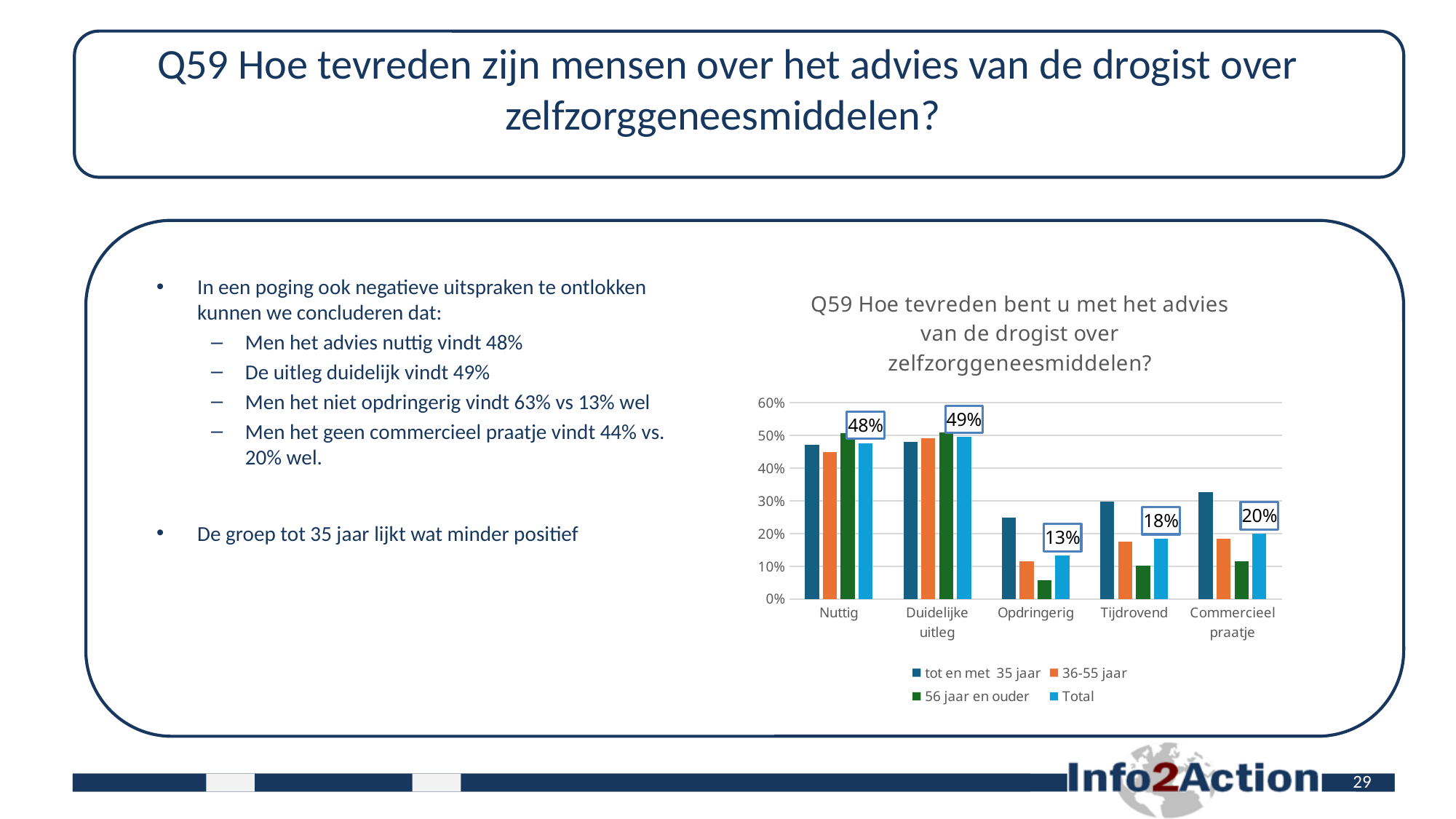
Is the value for '56 jaar en ouder' in Opdringerig greater or less than 10%? less How many categories are shown on the x axis? 5 Is the value for 'tot en met 35 jaar' in Commercieel praatje greater or less than 30%? greater What is the Total value for Opdringerig? 13% How many series does the legend list? 4 What is the difference between the Total values for Commercieel praatje and Opdringerig? 7 percentage points Which category has the highest labelled Total value? Duidelijke uitleg What is the Total value for Commercieel praatje? 20% What kind of chart is shown on the slide? Bar chart Which has a larger Total value: Tijdrovend or Commercieel praatje? Commercieel praatje Which category has the lowest labelled Total value? Opdringerig What is the Total value for Nuttig? 48%